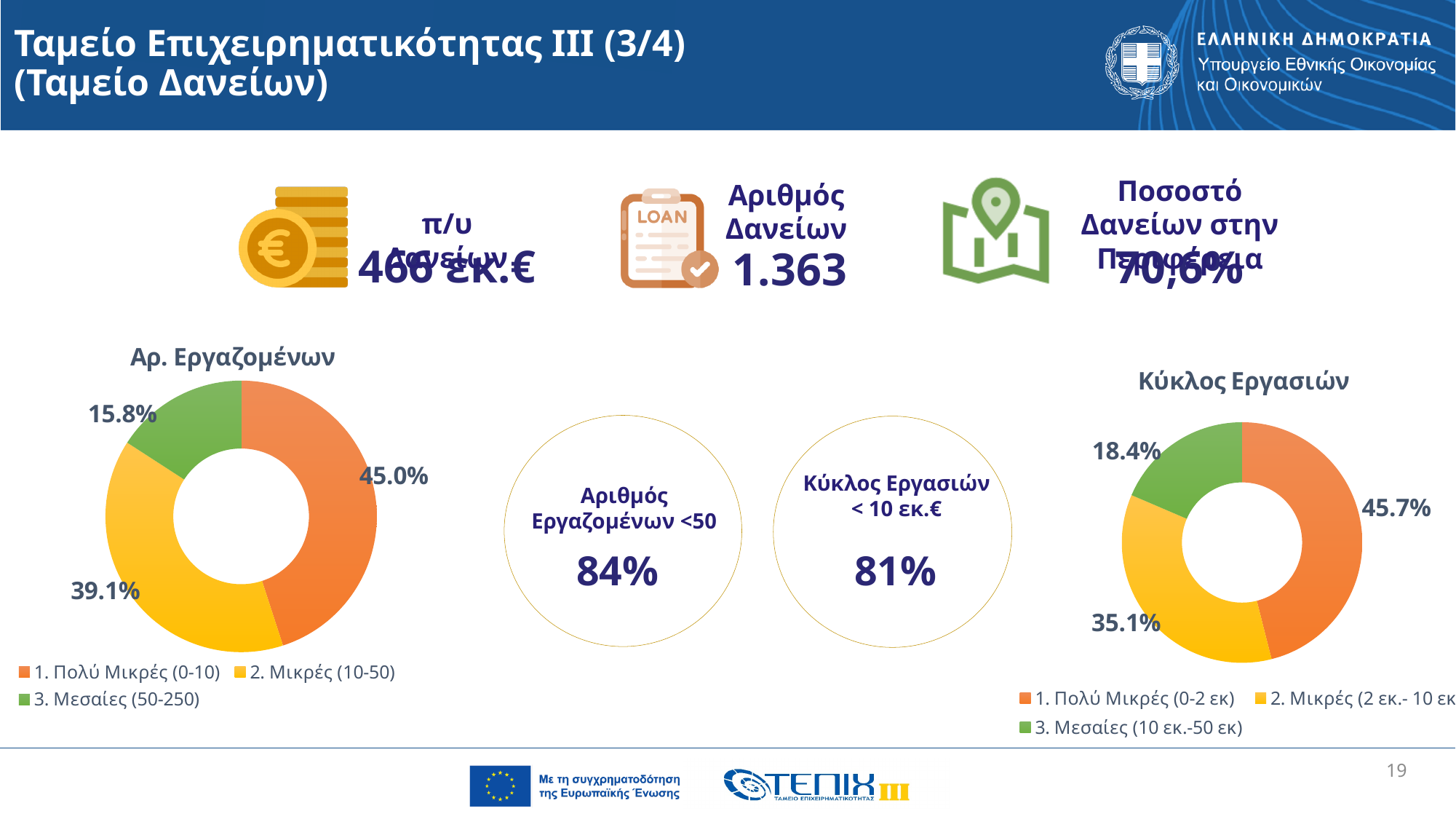
In the 'Κύκλος Εργασιών' chart, what share is shown for '1. Πολύ Μικρές (0-2 εκ)'? 45.7% In the 'Κύκλος Εργασιών' chart, what is the difference in percentage points between '2. Μικρές (2 εκ.- 10 εκ)' and '3. Μεσαίες (10 εκ.-50 εκ)'? 16.7 percentage points How many categories does the 'Κύκλος Εργασιών' chart show? 3 In the 'Κύκλος Εργασιών' chart, what share is shown for '2. Μικρές (2 εκ.- 10 εκ)'? 35.1% In the 'Κύκλος Εργασιών' chart, which category has the smallest share? 3. Μεσαίες (10 εκ.-50 εκ) In the 'Αρ. Εργαζομένων' chart, what share is shown for '3. Μεσαίες (50-250)'? 15.8% In the 'Αρ. Εργαζομένων' chart, what colour represents '2. Μικρές (10-50)'? Yellow In the 'Αρ. Εργαζομένων' chart, what is the difference in percentage points between '1. Πολύ Μικρές (0-10)' and '2. Μικρές (10-50)'? 5.9 percentage points In the 'Αρ. Εργαζομένων' chart, what share is shown for '1. Πολύ Μικρές (0-10)'? 45.0% In the 'Αρ. Εργαζομένων' chart, which category has the largest share? 1. Πολύ Μικρές (0-10) What type of chart is 'Αρ. Εργαζομένων'? Doughnut (pie) chart Which is larger: the share of '3. Μεσαίες' in the 'Αρ. Εργαζομένων' chart or in the 'Κύκλος Εργασιών' chart? Κύκλος Εργασιών